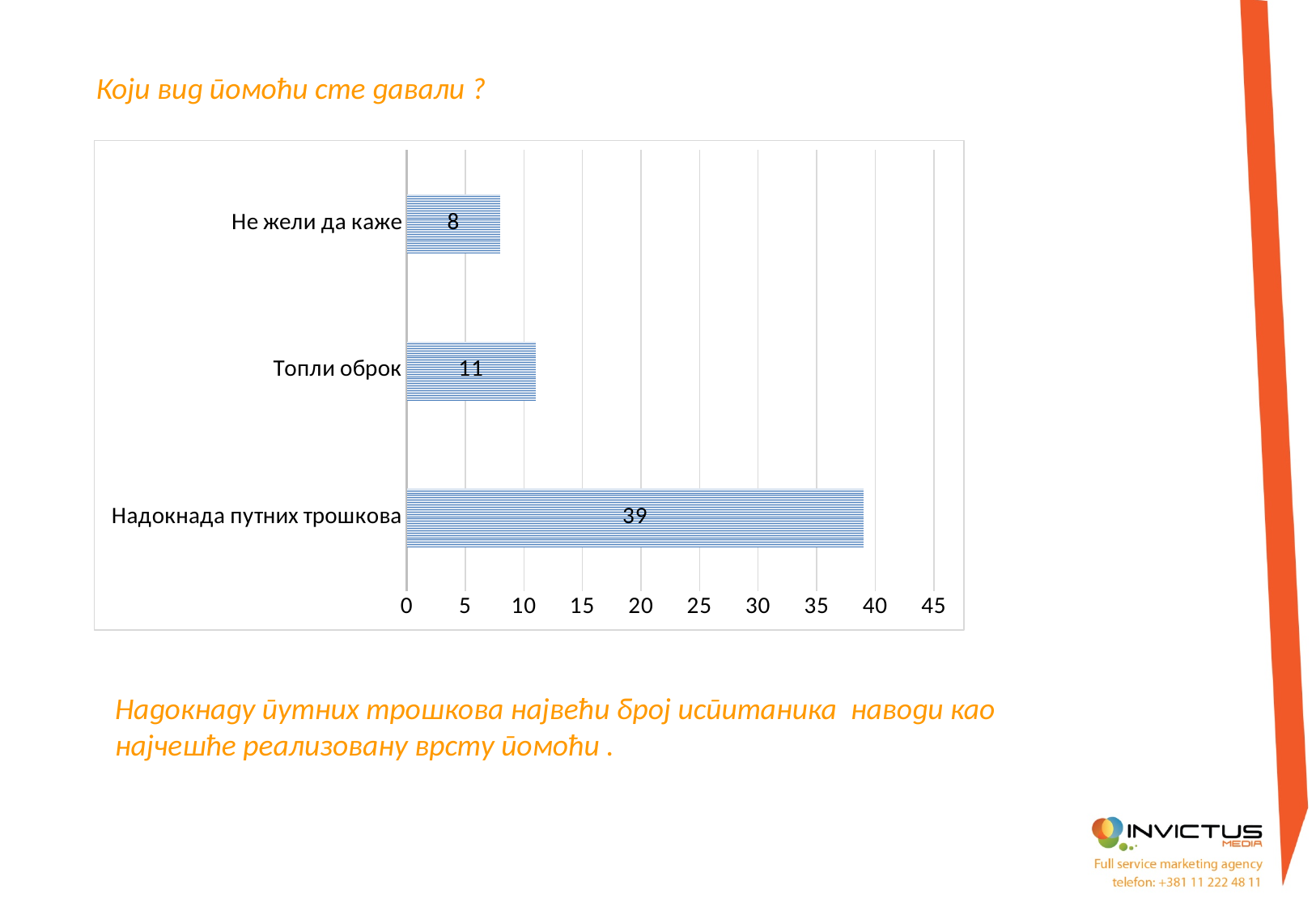
How many categories are shown in the chart? 3 What is the value for Не жели да каже? 8 What is the difference between the values for Топли оброк and Не жели да каже? 3 What is the difference between the values for Надокнада путних трошкова and Топли оброк? 28 What is the value for Топли оброк? 11 Which is larger, the value for Топли оброк or the value for Не жели да каже? Топли оброк Which category has the lowest value? Не жели да каже What is the highest value shown on the x axis? 45 What kind of chart is shown on the slide? bar chart Which category has the highest value? Надокнада путних трошкова What is the value for Надокнада путних трошкова? 39 Is the value for Надокнада путних трошкова greater or less than 35? greater